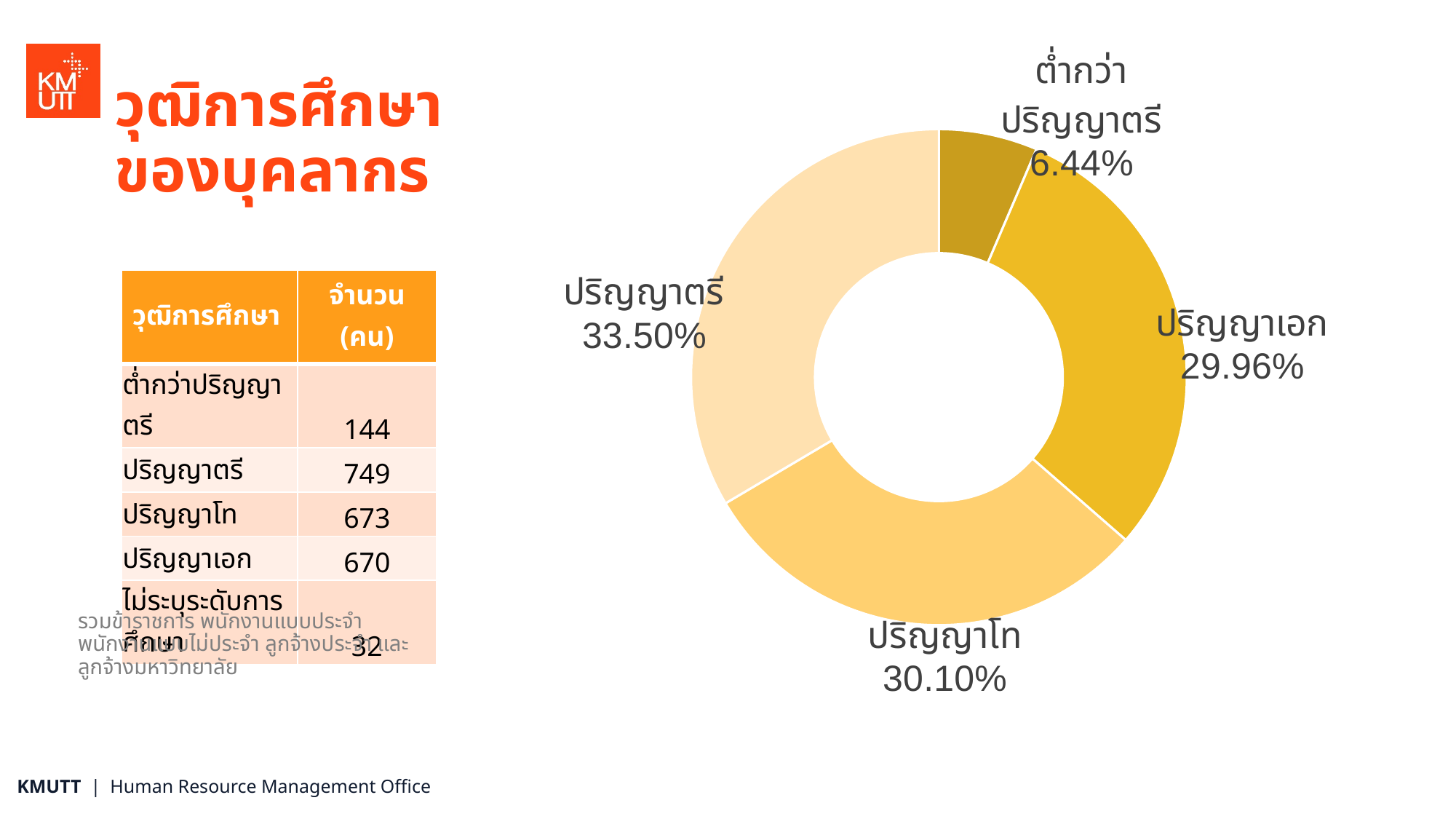
What share of the pie chart does ปริญญาโท represent? 30.10% What is the difference in percentage points between the ปริญญาตรี slice and the ต่ำกว่าปริญญาตรี slice? 27.06% How many slices does the pie chart have? 4 Which category has the smallest slice in the pie chart? ต่ำกว่าปริญญาตรี What kind of chart is shown on the slide? doughnut chart What share of the pie chart does ปริญญาตรี represent? 33.50% What share of the pie chart does ปริญญาเอก represent? 29.96% Which slice is larger in the pie chart, ปริญญาโท or ปริญญาเอก? ปริญญาโท Which slice is larger in the pie chart, ปริญญาตรี or ต่ำกว่าปริญญาตรี? ปริญญาตรี What is the difference in percentage points between the ปริญญาตรี slice and the ปริญญาโท slice? 3.40% Which category has the largest slice in the pie chart? ปริญญาตรี What share of the pie chart does ต่ำกว่าปริญญาตรี represent? 6.44%